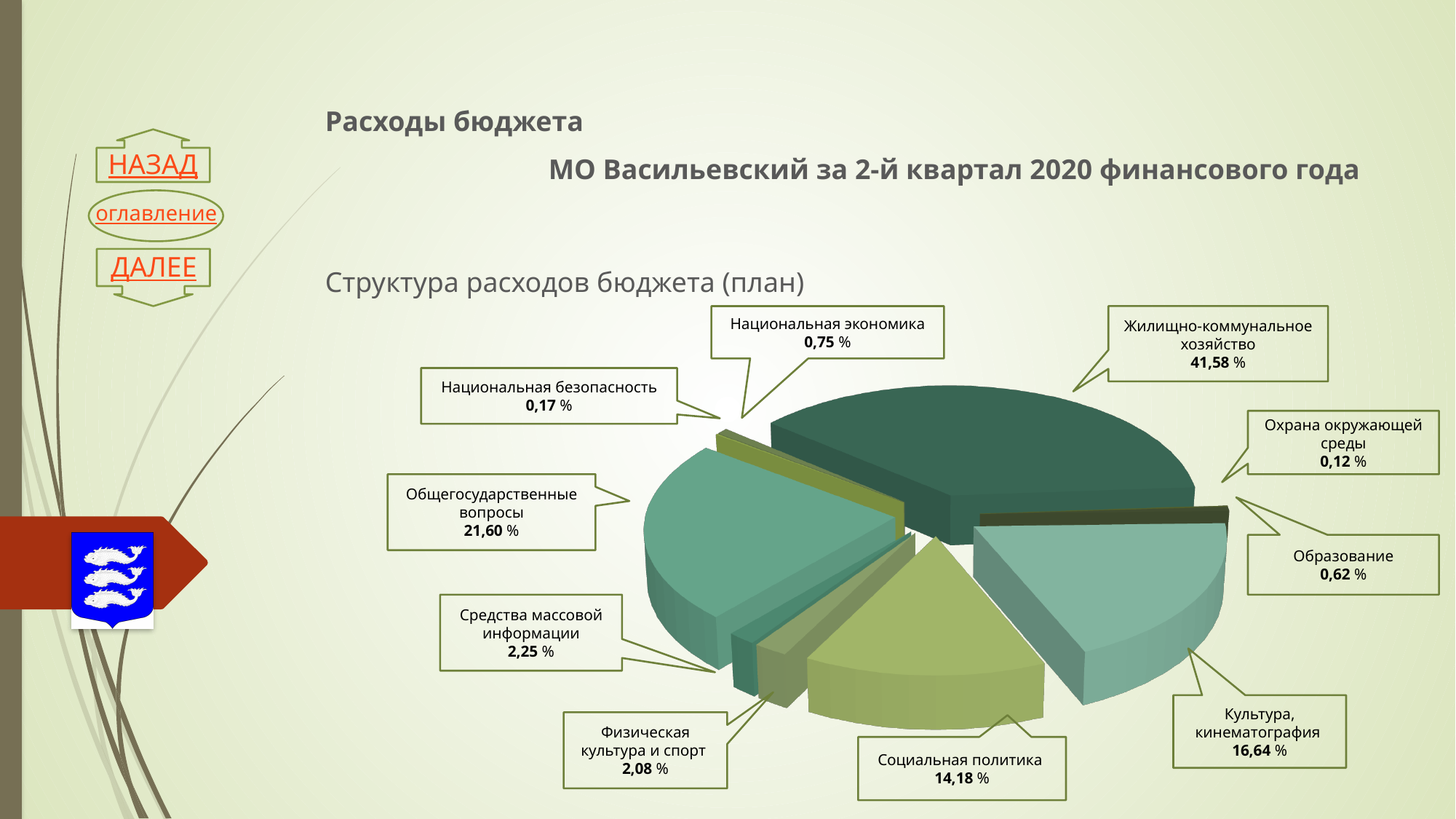
What is the title of the chart on the slide? Структура расходов бюджета (план) How many categories (slices) does the pie chart have? 10 What is the value shown for Физическая культура и спорт? 2,08 % Which category has the smallest share of the budget expenses? Охрана окружающей среды Which category has the largest share of the budget expenses? Жилищно-коммунальное хозяйство What share of the budget expenses is planned for Жилищно-коммунальное хозяйство? 41,58 % Which has a larger share: Средства массовой информации or Национальная экономика? Средства массовой информации What is the value shown for Социальная политика? 14,18 % What is the difference between the shares of Жилищно-коммунальное хозяйство and Общегосударственные вопросы? 19,98 % What kind of chart is shown on the slide? Pie chart What is the value shown for Общегосударственные вопросы? 21,60 % What is the difference between the shares of Культура, кинематография and Социальная политика? 2,46 %